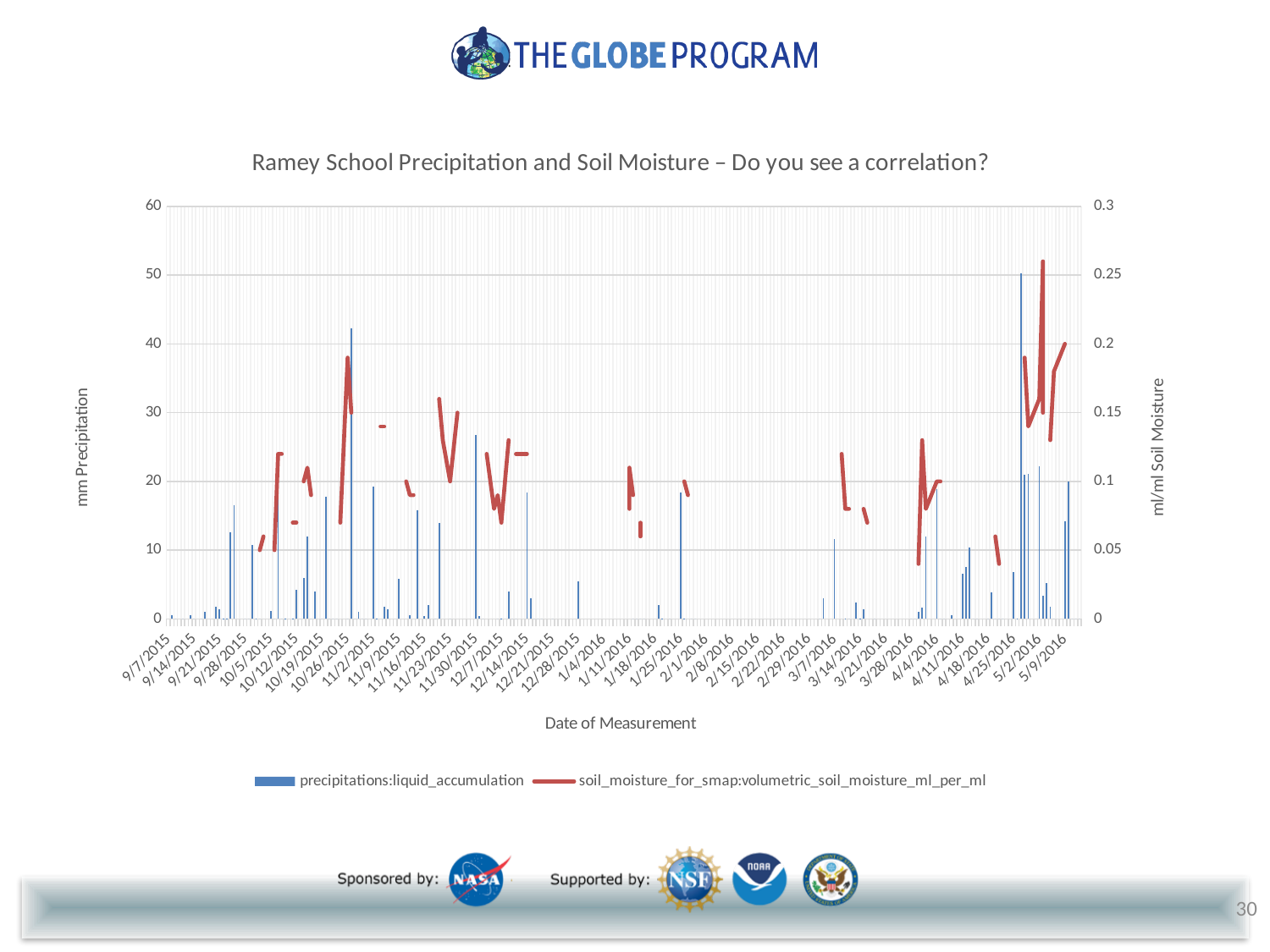
What is the highest tick value shown on the right soil moisture axis? 0.3 Is the peak soil moisture value near 5/2/2016 greater or less than 0.2 ml/ml? greater Which series is drawn as a red line? soil_moisture_for_smap:volumetric_soil_moisture_ml_per_ml What is the highest tick value shown on the left precipitation axis? 60 What is the label of the right vertical axis? ml/ml Soil Moisture What is the title of the chart? Ramey School Precipitation and Soil Moisture – Do you see a correlation? Is the soil moisture value near 4/18/2016 greater or less than 0.1 ml/ml? less How many series does the chart legend list? 2 Is the tallest precipitation bar, near 5/2/2016, greater or less than 40 mm? greater What is the label of the left vertical axis? mm Precipitation What kind of chart is this? Combined bar and line chart What is the label of the horizontal axis? Date of Measurement